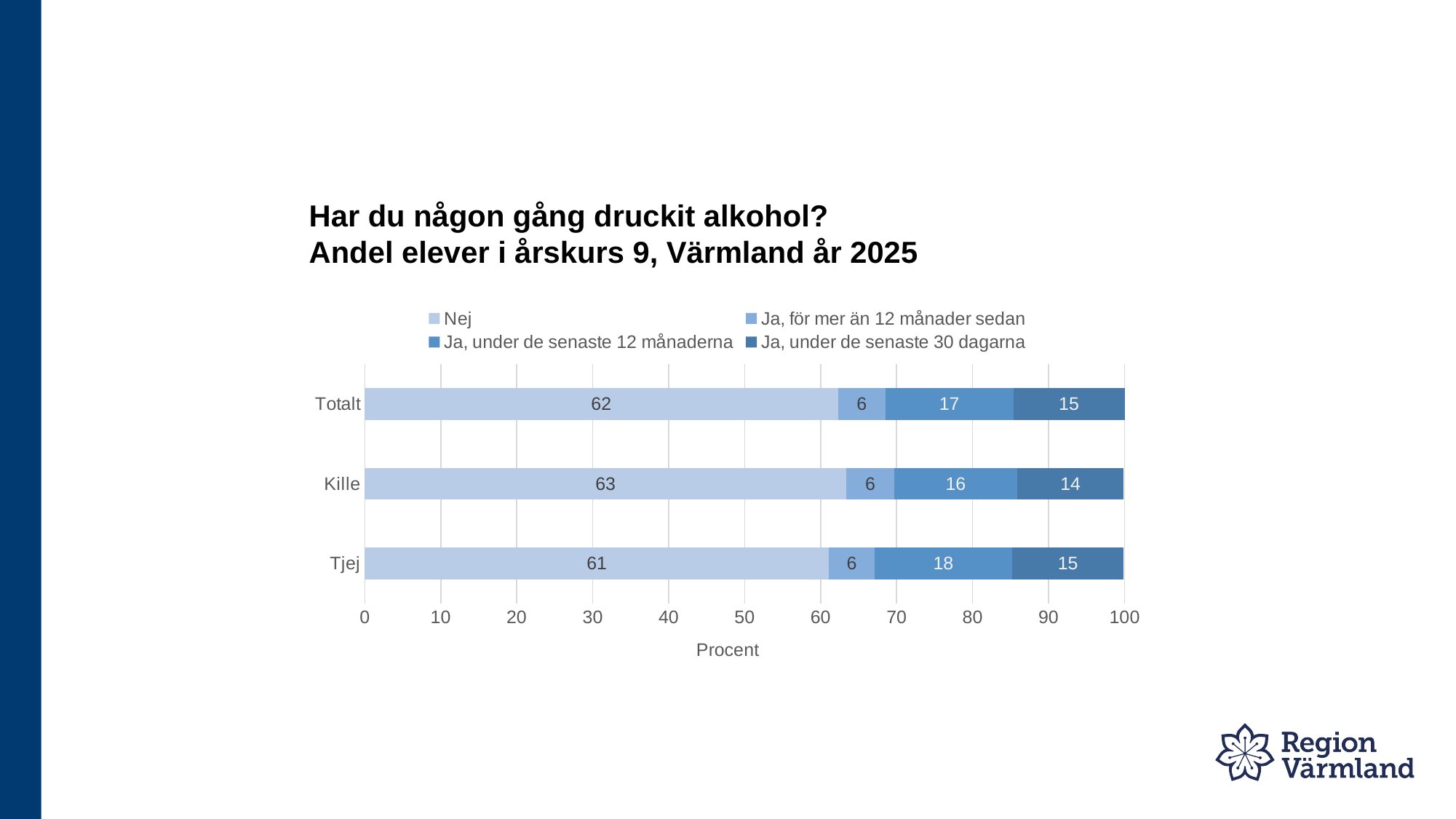
What is the value for "Nej" for Totalt? 62 How many categories are shown on the y axis? 3 Which category has the lowest value for "Ja, under de senaste 12 månaderna"? Kille What is the value for "Ja, för mer än 12 månader sedan" for Kille? 6 How many series does the legend list? 4 What is the value for "Ja, under de senaste 12 månaderna" for Tjej? 18 Which category has the highest value for "Nej"? Kille What is the total of the stacked bar for Kille? 99 Which is larger: the "Ja, under de senaste 12 månaderna" value for Tjej or for Totalt? Tjej What is the value for "Ja, under de senaste 30 dagarna" for Kille? 14 What kind of chart is shown? Stacked bar chart What is the difference between the "Nej" values for Kille and Tjej? 2